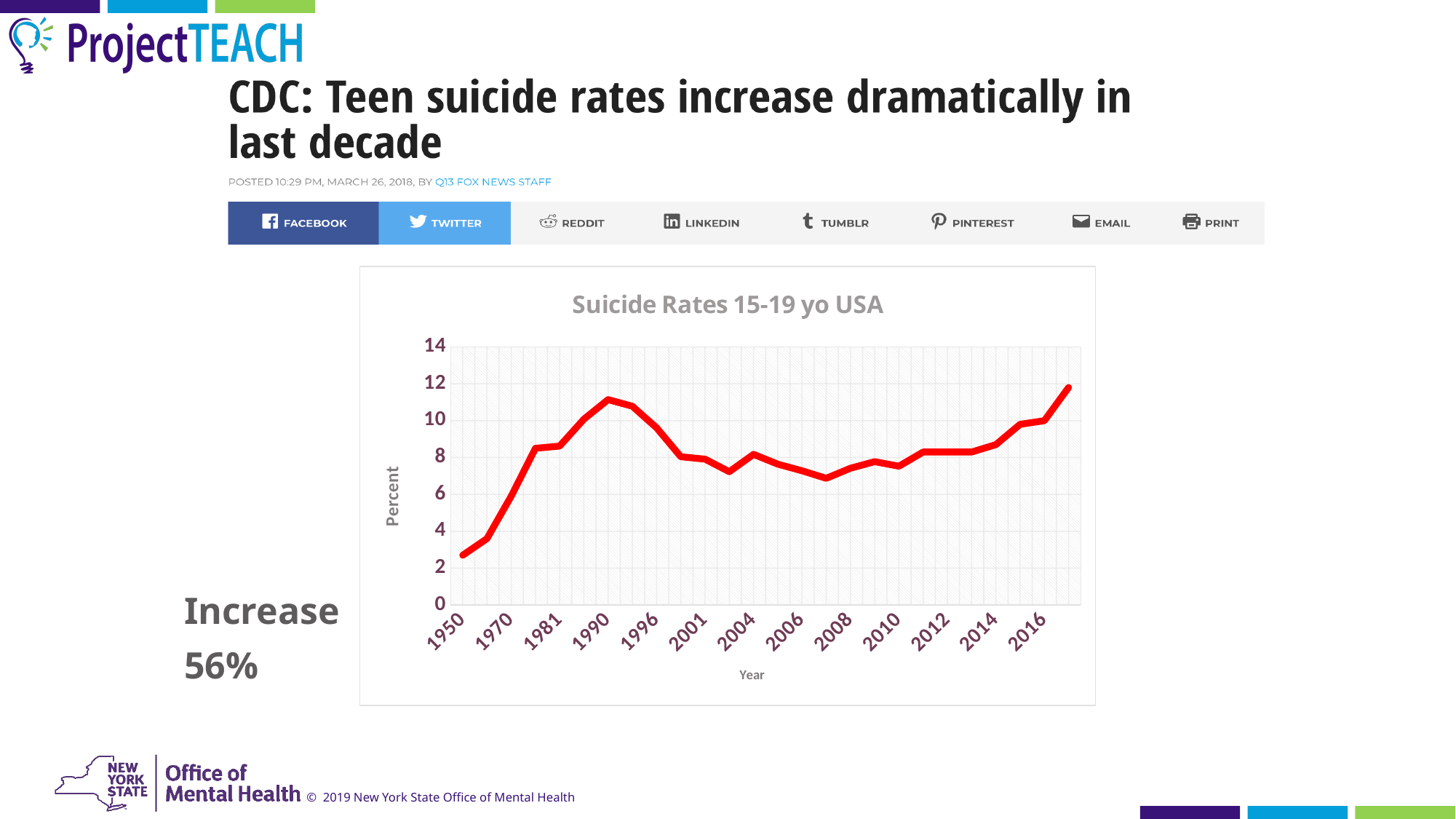
Is the value for 2016 greater or less than 8? greater What is the title of the chart? Suicide Rates 15-19 yo USA Is the value for 1950 greater or less than 4? less What is the label on the vertical axis of the chart? Percent Which labeled year has the lowest value on the chart? 1950 Which is larger, the value for 1990 or the value for 2008? 1990 Is the value for 1990 greater or less than 10? greater Do the values rise or fall from 2008 to 2016? rise How many year labels are shown on the x axis? 13 What kind of chart is shown on the slide? line chart